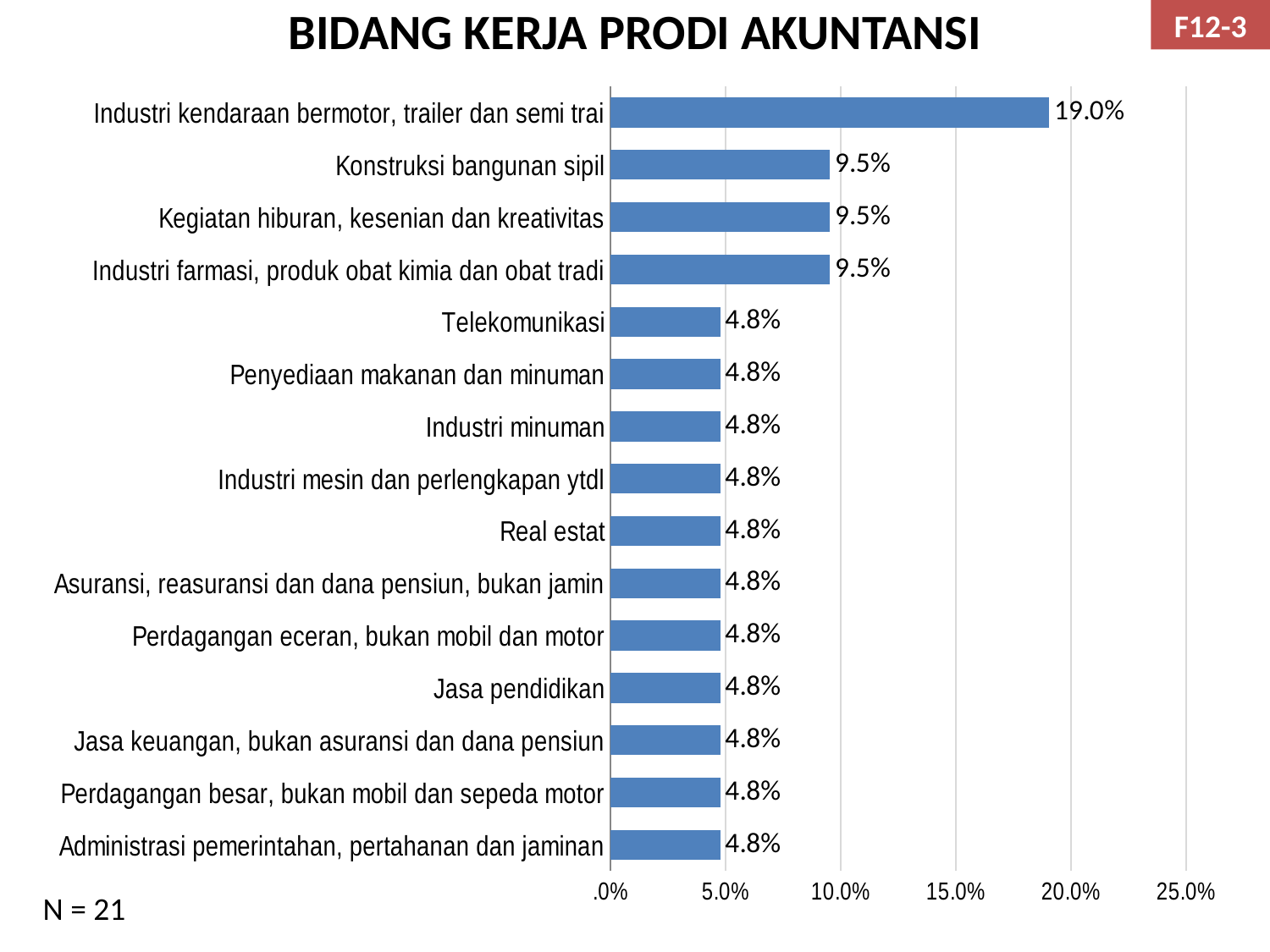
What is the value for Konstruksi bangunan sipil? 9.5% What is the value for Industri kendaraan bermotor, trailer dan semi trai? 19.0% Is the value for Industri minuman greater or less than 5.0%? less What is the difference between the value for Industri kendaraan bermotor, trailer dan semi trai and the value for Konstruksi bangunan sipil? 9.5% What kind of chart is shown on the slide? bar chart What is the difference between the value for Kegiatan hiburan, kesenian dan kreativitas and the value for Real estat? 4.7% What is the value for Telekomunikasi? 4.8% How many categories are shown in the chart? 15 Which is larger, the value for Industri farmasi, produk obat kimia dan obat tradi or the value for Jasa pendidikan? Industri farmasi, produk obat kimia dan obat tradi Which category has the highest value? Industri kendaraan bermotor, trailer dan semi trai What is the title of the chart? BIDANG KERJA PRODI AKUNTANSI Is the value for Industri kendaraan bermotor, trailer dan semi trai greater or less than 15.0%? greater